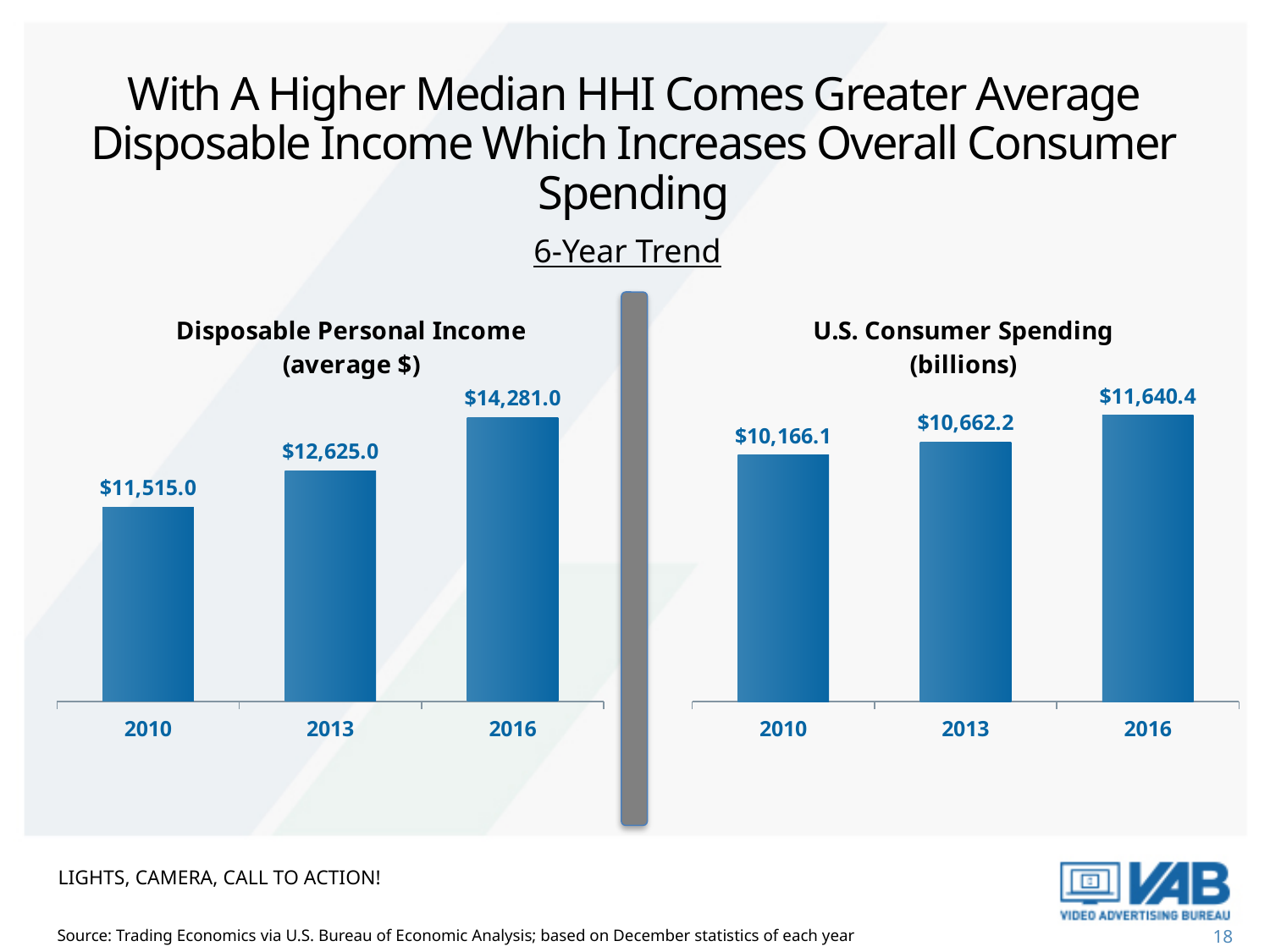
In the U.S. Consumer Spending (billions) chart, what is the value for 2013? $10,662.2 In the U.S. Consumer Spending (billions) chart, what is the value for 2016? $11,640.4 In the Disposable Personal Income (average $) chart, which year has the highest value? 2016 How many years are shown in the Disposable Personal Income (average $) chart? 3 In the Disposable Personal Income (average $) chart, do the values rise or fall from 2010 to 2016? Rise In the Disposable Personal Income (average $) chart, what is the value for 2010? $11,515.0 What type of chart is the U.S. Consumer Spending (billions) chart? Bar chart In the Disposable Personal Income (average $) chart, what is the value for 2016? $14,281.0 In the U.S. Consumer Spending (billions) chart, which is larger, the value for 2010 or the value for 2013? 2013 In the Disposable Personal Income (average $) chart, what is the difference between the 2016 and 2010 values? $2,766.0 In the U.S. Consumer Spending (billions) chart, which year has the lowest value? 2010 In the U.S. Consumer Spending (billions) chart, what is the difference between the 2016 and 2013 values? $978.2